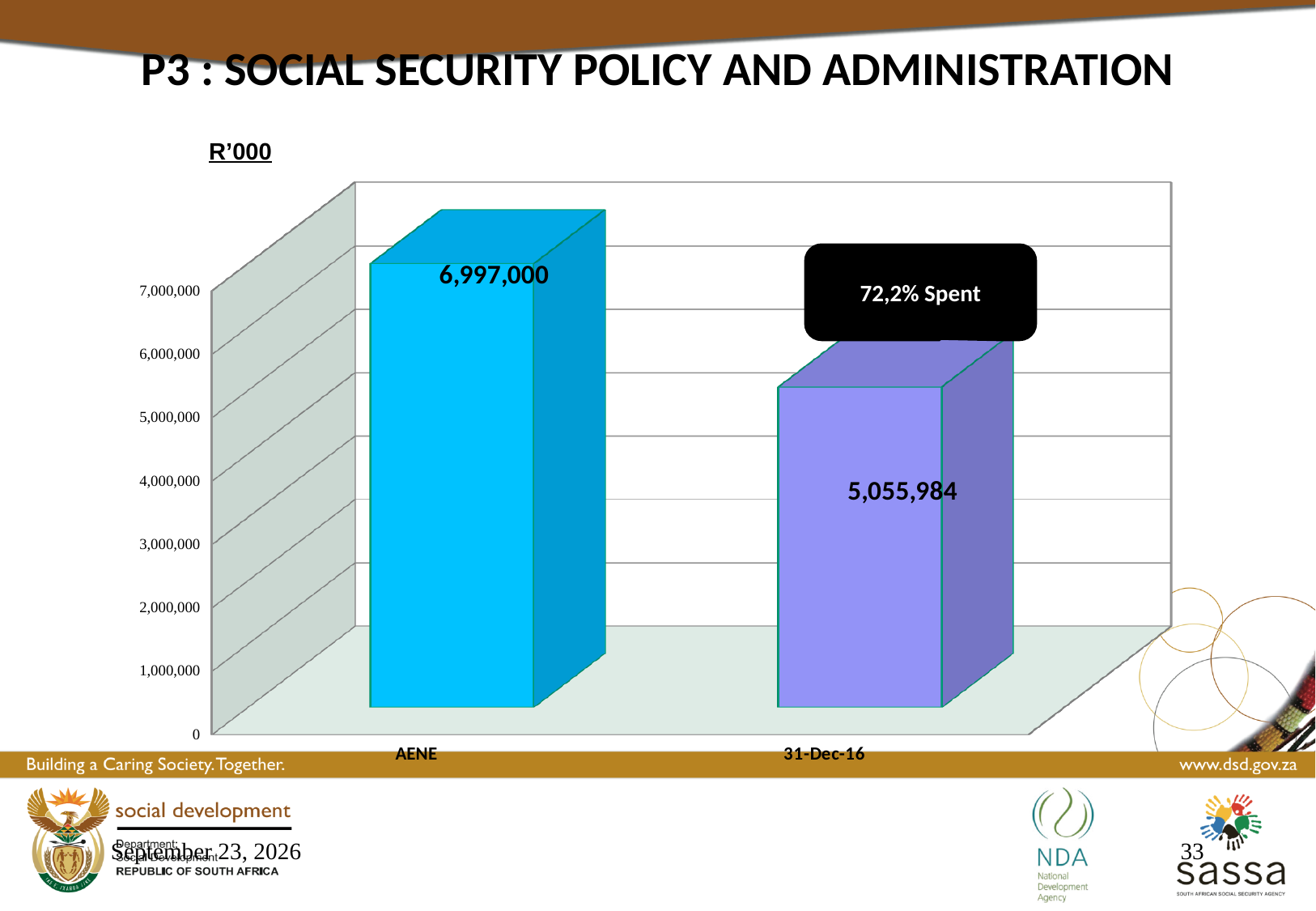
Is the value for 31-Dec-16 greater or less than 6,000,000? less What unit label is shown above the chart? R'000 How many bars are shown in the chart? 2 What is the value for 31-Dec-16? 5,055,984 What kind of chart is shown on the slide? bar chart Which category has the lowest value? 31-Dec-16 What is the difference between the AENE value and the 31-Dec-16 value? 1,941,016 Is the value for AENE greater or less than 6,000,000? greater What percentage spent is shown in the callout on the chart? 72,2% Spent Which category has the highest value? AENE Which is larger, the value for AENE or the value for 31-Dec-16? AENE What is the value for AENE? 6,997,000